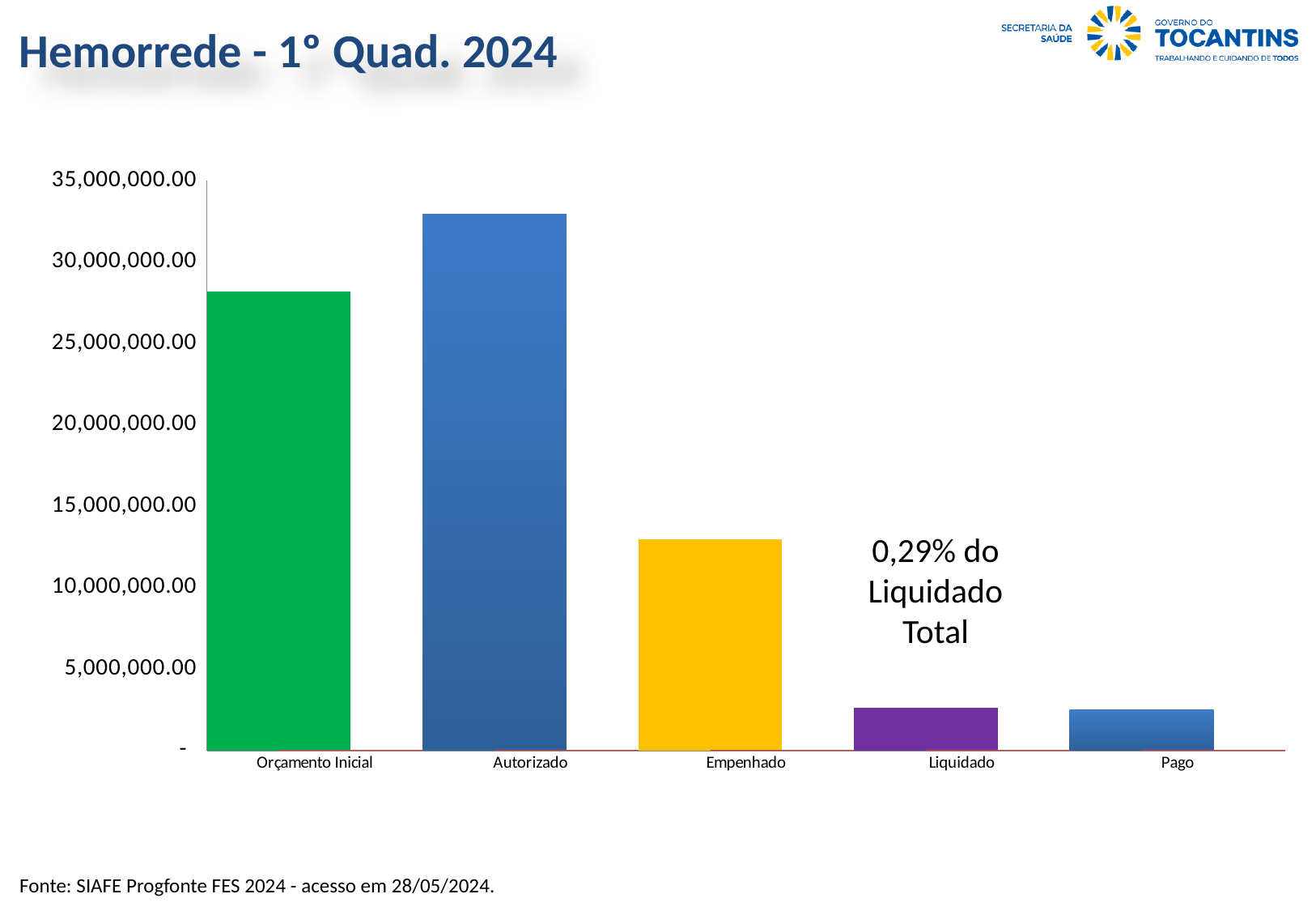
Is the value for Empenhado greater or less than 10,000,000.00? greater Is the value for Empenhado greater or less than 15,000,000.00? less What is the title of the slide containing the chart? Hemorrede - 1° Quad. 2024 Is the value for Liquidado greater or less than 5,000,000.00? less What kind of chart is shown on the slide? bar chart How many categories are shown on the x axis of the chart? 5 Which is larger, the value for Orçamento Inicial or the value for Pago? Orçamento Inicial Which category has the highest value in the chart? Autorizado Which is larger, the value for Autorizado or the value for Empenhado? Autorizado